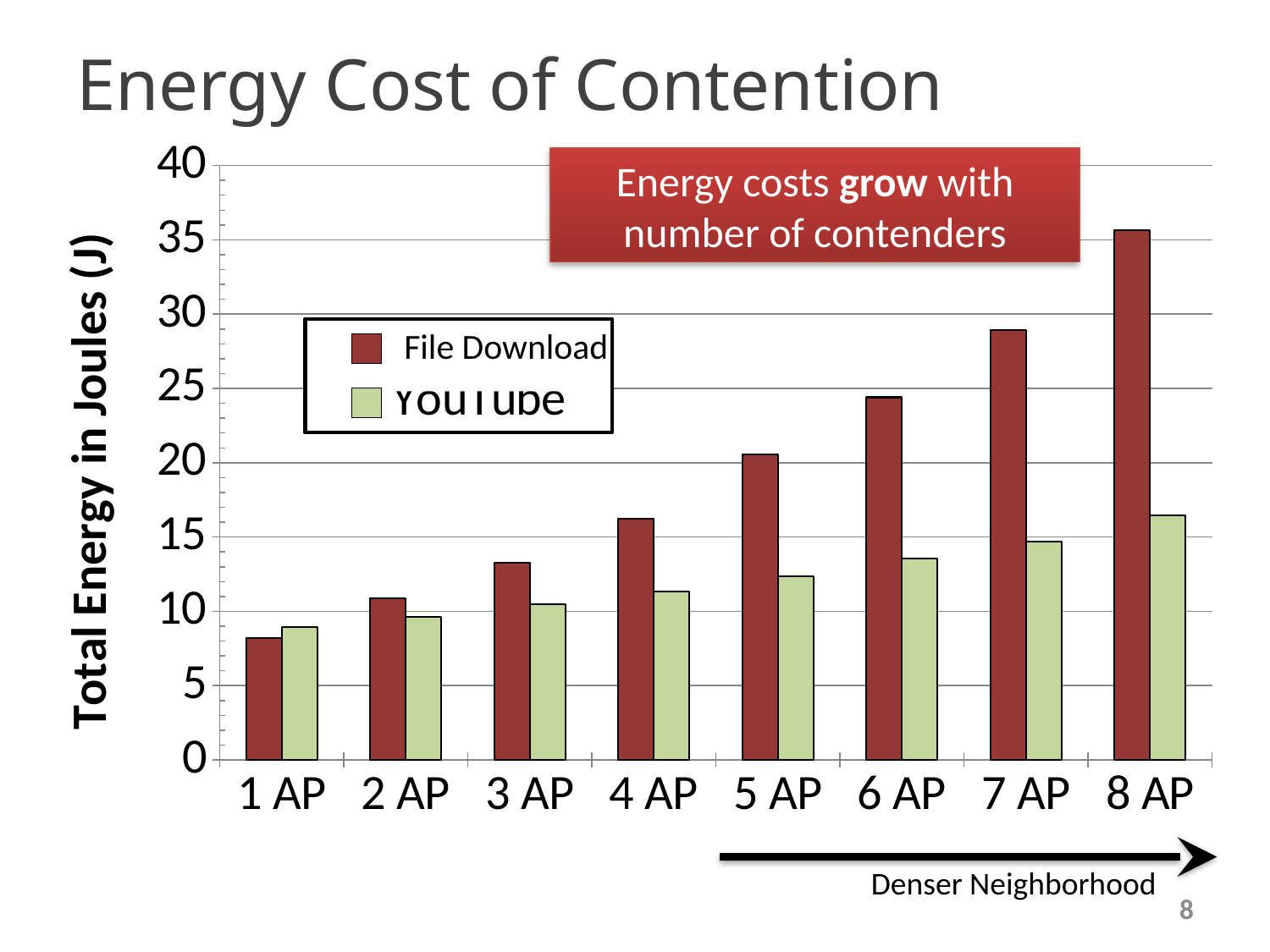
Do the File Download values rise or fall as the number of APs increases from 1 AP to 8 AP? rise How many AP categories are shown on the x axis? 8 Is the File Download value for 8 AP greater or less than 30? greater For which category is the YouTube value highest? 8 AP What is the label of the y axis? Total Energy in Joules (J) Is the YouTube value for 8 AP greater or less than 15? greater For which category is the File Download value lowest? 1 AP How many series does the legend list? 2 At 8 AP, which series has the larger value, File Download or YouTube? File Download What kind of chart is shown on the slide? bar chart For which category is the File Download value highest? 8 AP Is the File Download value for 1 AP greater or less than 10? less